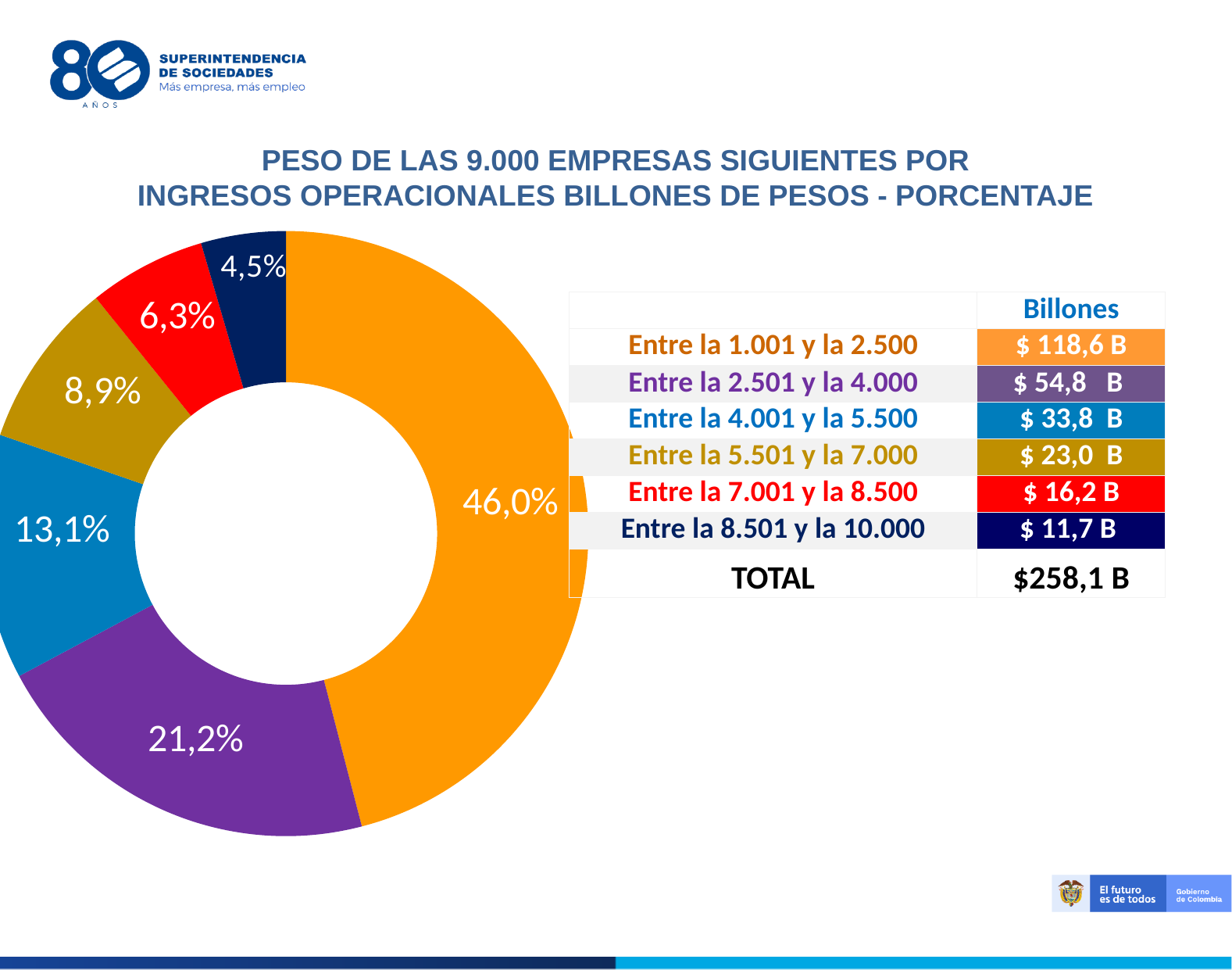
Which group has the smallest share of the donut chart? Entre la 8.501 y la 10.000 What is the title of the chart on the slide? PESO DE LAS 9.000 EMPRESAS SIGUIENTES POR INGRESOS OPERACIONALES BILLONES DE PESOS - PORCENTAJE What percentage is shown on the largest (orange) slice of the donut chart? 46,0% What kind of chart is shown on the slide? Pie chart (donut) What percentage is shown on the smallest (dark navy) slice of the donut chart? 4,5% What percentage does the red slice (Entre la 7.001 y la 8.500) show? 6,3% What percentage is shown on the purple slice of the donut chart? 21,2% What percentage does the light blue slice (Entre la 4.001 y la 5.500) show? 13,1% Which slice is larger: the light blue slice or the gold slice? The light blue slice (13,1%) How many slices does the donut chart have? 6 Which group has the largest share of the donut chart? Entre la 1.001 y la 2.500 What is the difference in percentage points between the orange slice (46,0%) and the purple slice (21,2%)? 24,8 percentage points